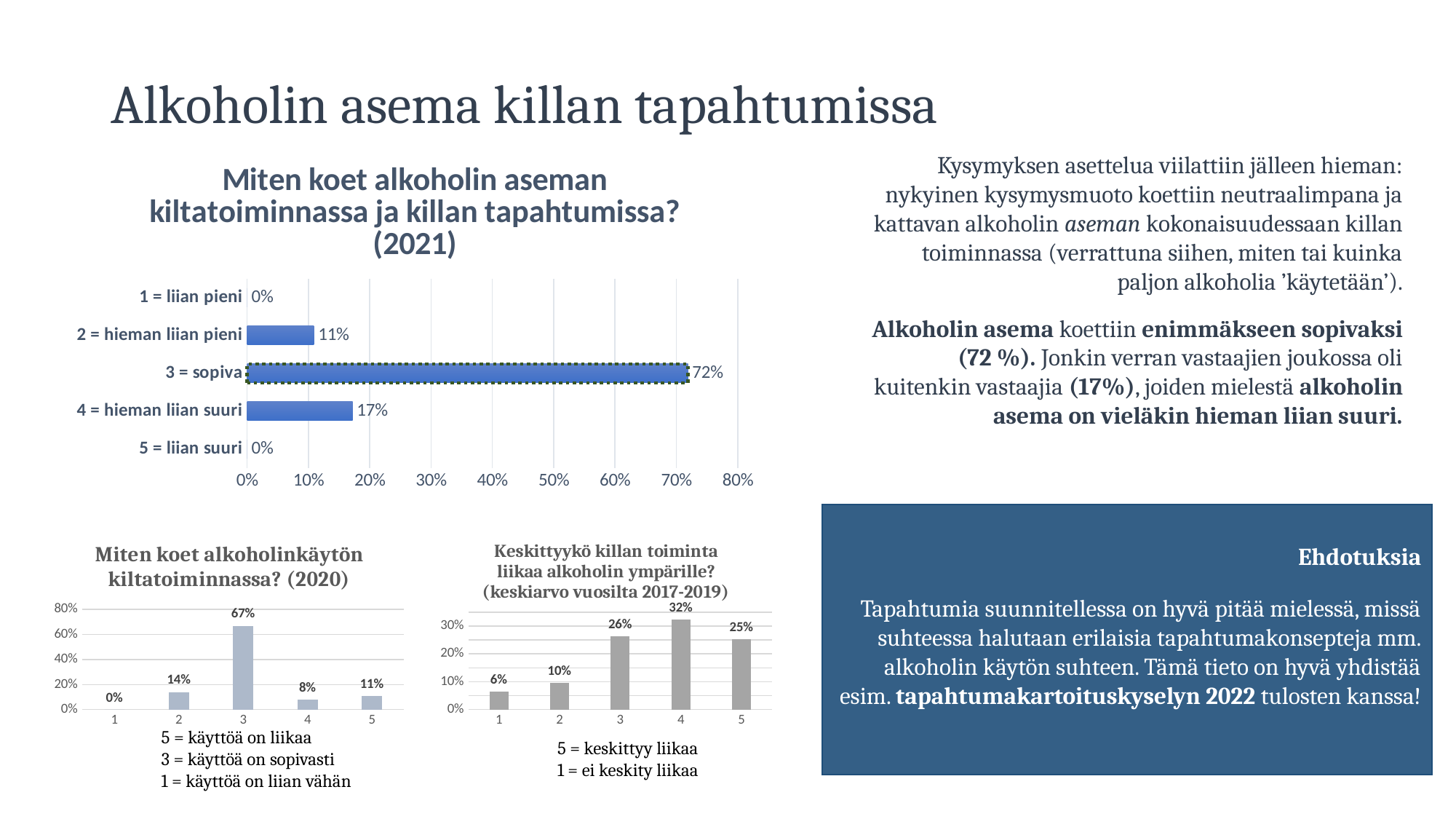
What type of chart is the 2021 chart at the top left? Bar chart In the 2020 chart at the bottom left, which of category 2 or category 4 has the larger value? Category 2 In the chart 'Keskittyykö killan toiminta liikaa alkoholin ympärille?', which category has the highest value? 4 In the 2020 chart 'Miten koet alkoholinkäytön kiltatoiminnassa?', what is the value for category 3? 67% In the 2021 chart at the top left, what is the value for '4 = hieman liian suuri'? 17% In the 2021 chart at the top left, how many categories are shown? 5 In the chart 'Keskittyykö killan toiminta liikaa alkoholin ympärille?', what is the difference between category 4 and category 5? 7% In the 2021 chart at the top left, what is the difference between '3 = sopiva' and '2 = hieman liian pieni'? 61% In the chart 'Keskittyykö killan toiminta liikaa alkoholin ympärille?', what is the value for category 1? 6% In the 2021 chart 'Miten koet alkoholin aseman kiltatoiminnassa ja killan tapahtumissa?', what is the value for '3 = sopiva'? 72% In the 2020 chart at the bottom left, what is the difference between category 2 and category 5? 3% In the 2021 chart at the top left, which category has the highest value? 3 = sopiva